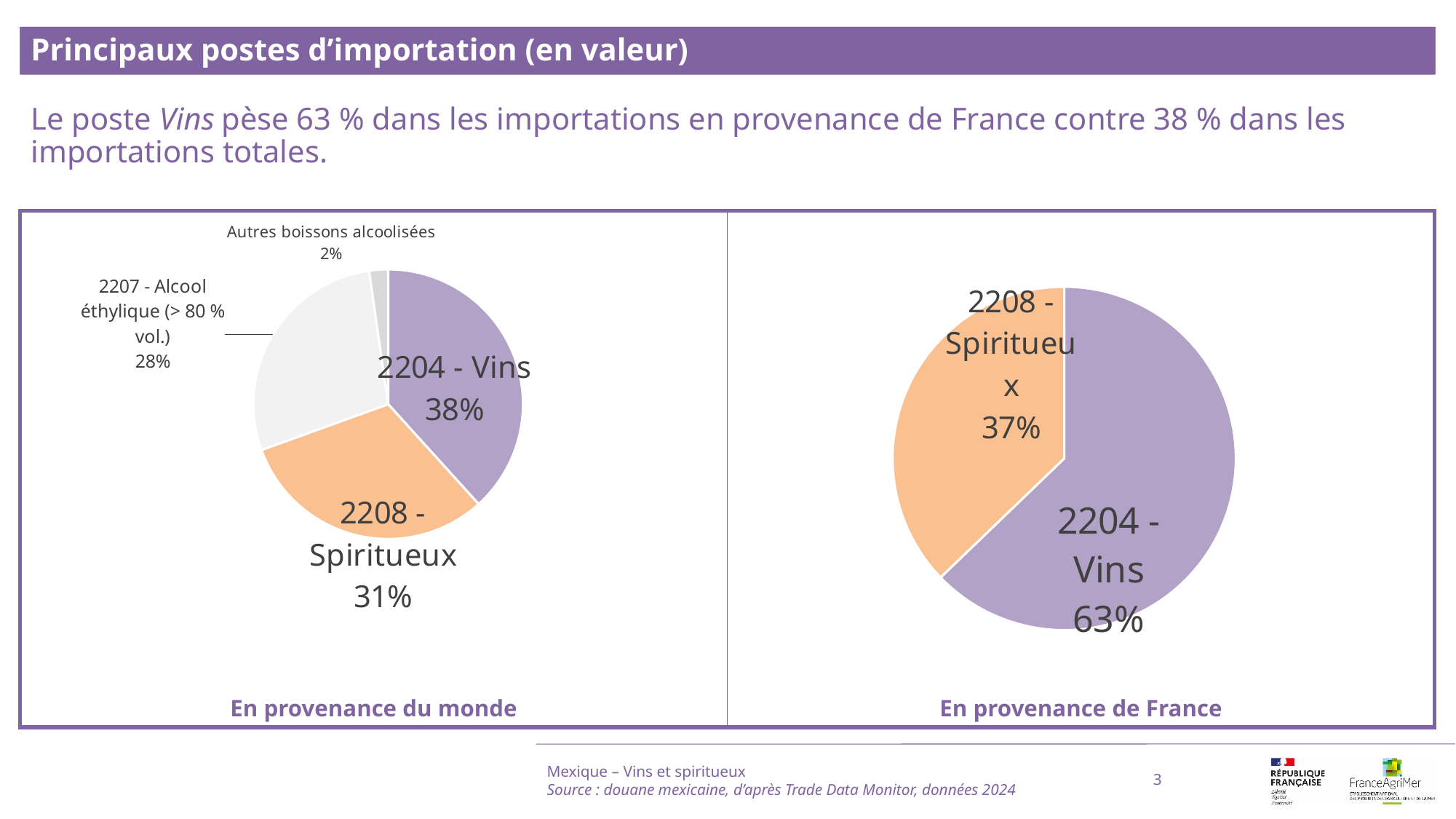
In the 'En provenance du monde' pie chart, what share does '2208 - Spiritueux' have? 31% In the 'En provenance du monde' pie chart, what share does '2204 - Vins' have? 38% In the 'En provenance du monde' pie chart, what share does '2207 - Alcool éthylique (> 80 % vol.)' have? 28% In the 'En provenance de France' pie chart, what is the difference in percentage points between '2204 - Vins' and '2208 - Spiritueux'? 26 percentage points Which is larger: the share of '2204 - Vins' in the 'En provenance du monde' chart or in the 'En provenance de France' chart? En provenance de France In the 'En provenance du monde' pie chart, how many slices are there? 4 In the 'En provenance du monde' pie chart, which category has the smallest share? Autres boissons alcoolisées In the 'En provenance du monde' pie chart, which category has the largest share? 2204 - Vins What kind of chart is used on the slide for 'En provenance du monde' and 'En provenance de France'? Pie chart